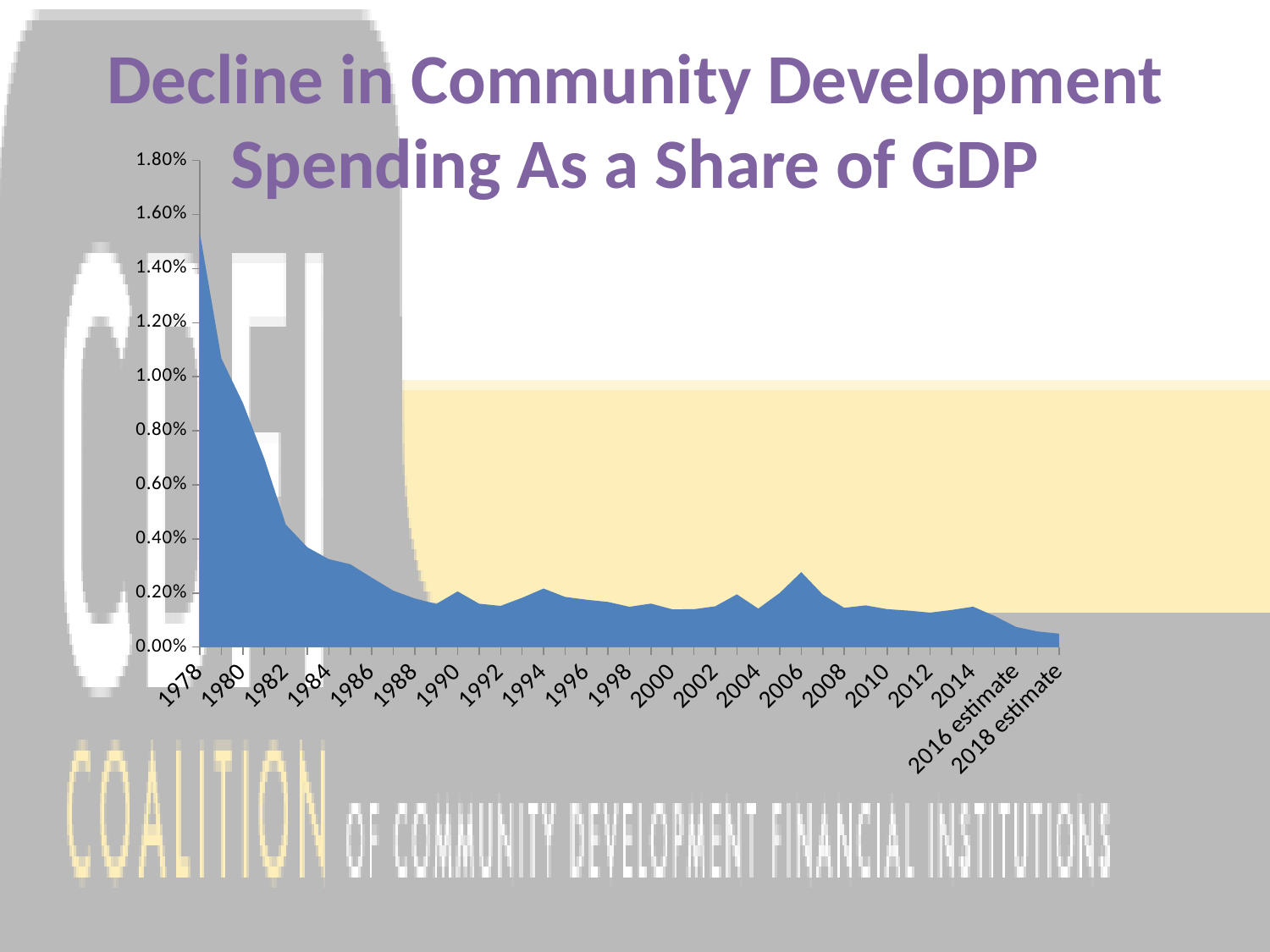
Which point on the x axis has the lowest value? 2018 estimate What is the title of the chart? Decline in Community Development Spending As a Share of GDP What is the highest value shown on the y axis? 1.80% Is the value for the 2018 estimate greater or less than 0.20%? less Is the value for 2006 greater or less than 0.20%? greater Which year has the highest community development spending as a share of GDP? 1978 Is the value for 1986 greater or less than 0.40%? less Which is larger, the value for 1980 or the value for 1990? 1980 Do the values generally rise or fall from 1978 to 2018? fall What kind of chart is shown on the slide? area chart Which is larger, the value for 2006 or the value for 2010? 2006